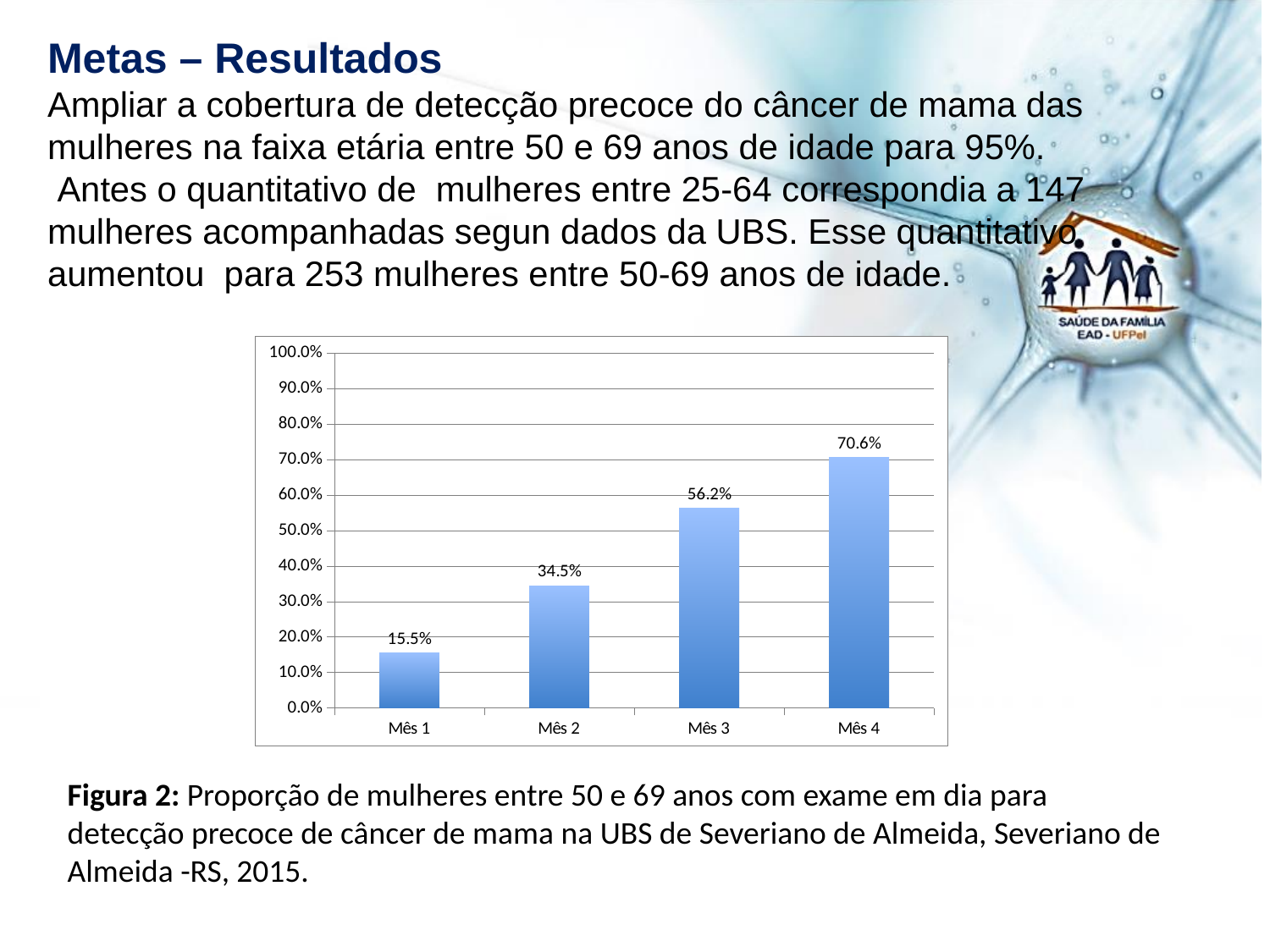
What kind of chart is shown on the slide? bar chart What is the value for Mês 1? 15.5% What is the value for Mês 4? 70.6% What is the value for Mês 3? 56.2% How many months are shown on the x axis? 4 Which is larger, the value for Mês 2 or the value for Mês 3? Mês 3 What is the difference between the values for Mês 4 and Mês 3? 14.4% Do the values rise or fall from Mês 1 to Mês 4? rise Which month has the highest value? Mês 4 Which month has the lowest value? Mês 1 What is the difference between the values for Mês 2 and Mês 1? 19.0% Is the value for Mês 2 greater or less than 40.0%? less